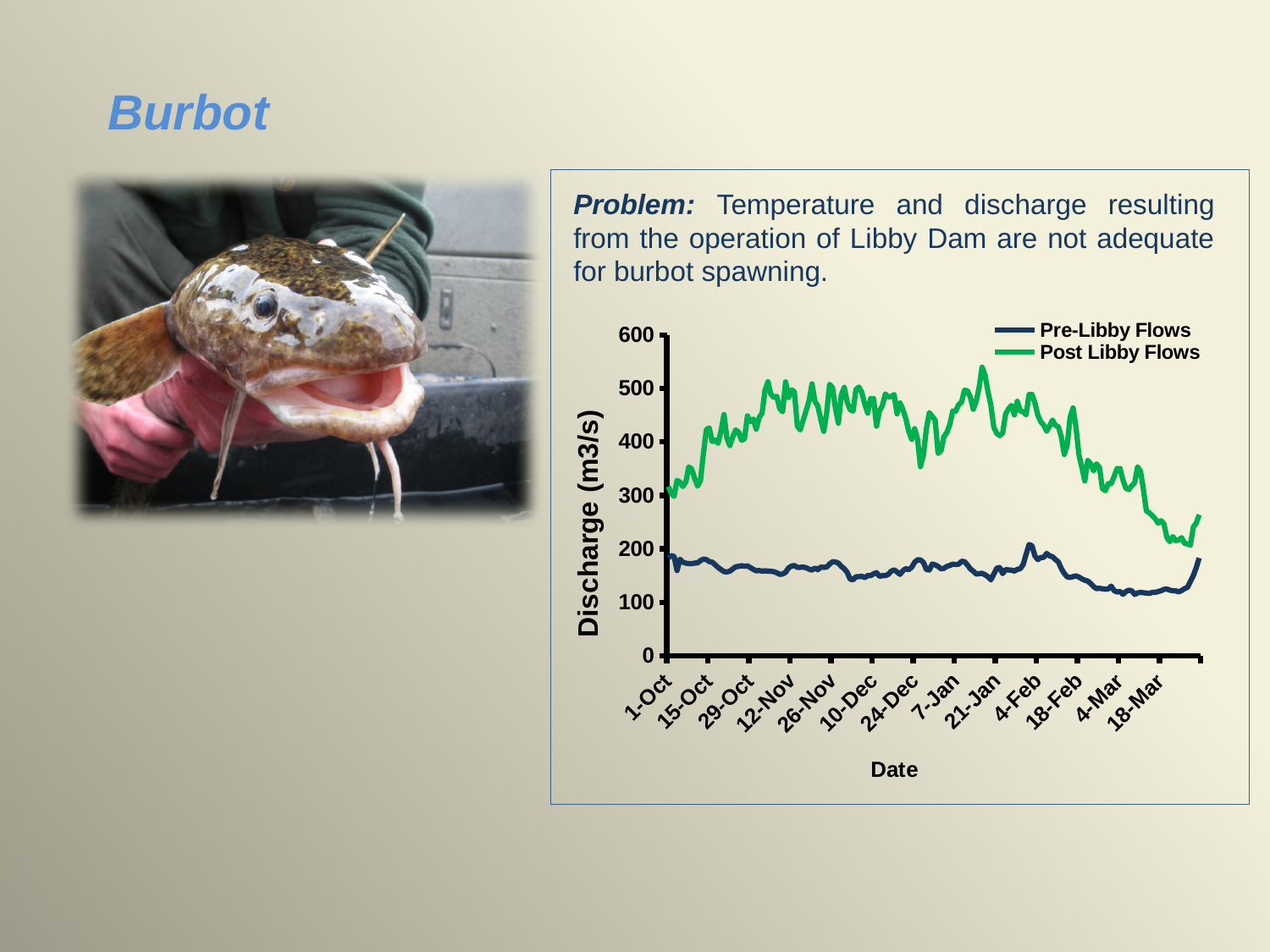
Is the Post Libby Flows value at 12-Nov greater or less than 400? greater Do the Post Libby Flows values rise or fall between 4-Feb and 18-Mar? fall Is the Post Libby Flows value at 18-Mar greater or less than 300? less What is the label of the chart's vertical axis? Discharge (m3/s) Which series has higher discharge values across the chart, Pre-Libby Flows or Post Libby Flows? Post Libby Flows How many series does the chart legend list? 2 Is the Pre-Libby Flows value at 4-Mar greater or less than 200? less What are the two series named in the chart legend? Pre-Libby Flows and Post Libby Flows How many date tick labels are shown along the x axis of the chart? 13 What kind of chart is shown on the slide? line chart